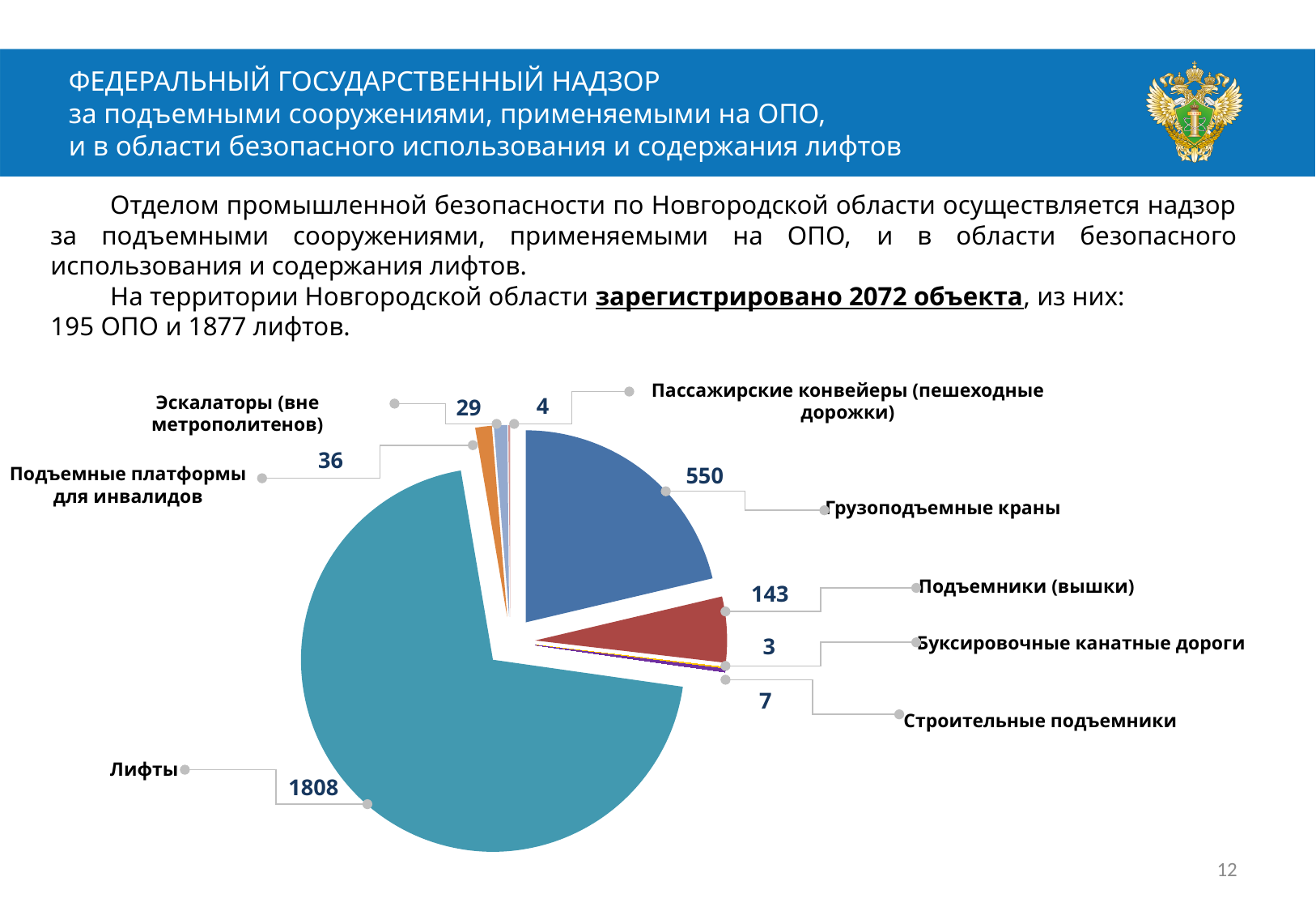
Which is larger: Эскалаторы (вне метрополитенов) or Подъемные платформы для инвалидов? Подъемные платформы для инвалидов Which category has the smallest value in the pie chart? Буксировочные канатные дороги What is the value for Подъемники (вышки)? 143 Which category has the largest slice of the pie chart? Лифты What is the value for Подъемные платформы для инвалидов? 36 What is the value for Грузоподъемные краны? 550 What is the value for Лифты in the pie chart? 1808 How many categories does the pie chart show? 8 What is the difference between the values for Строительные подъемники and Буксировочные канатные дороги? 4 What is the difference between the values for Лифты and Грузоподъемные краны? 1258 What is the value for Пассажирские конвейеры (пешеходные дорожки)? 4 What type of chart is shown on the slide? pie chart